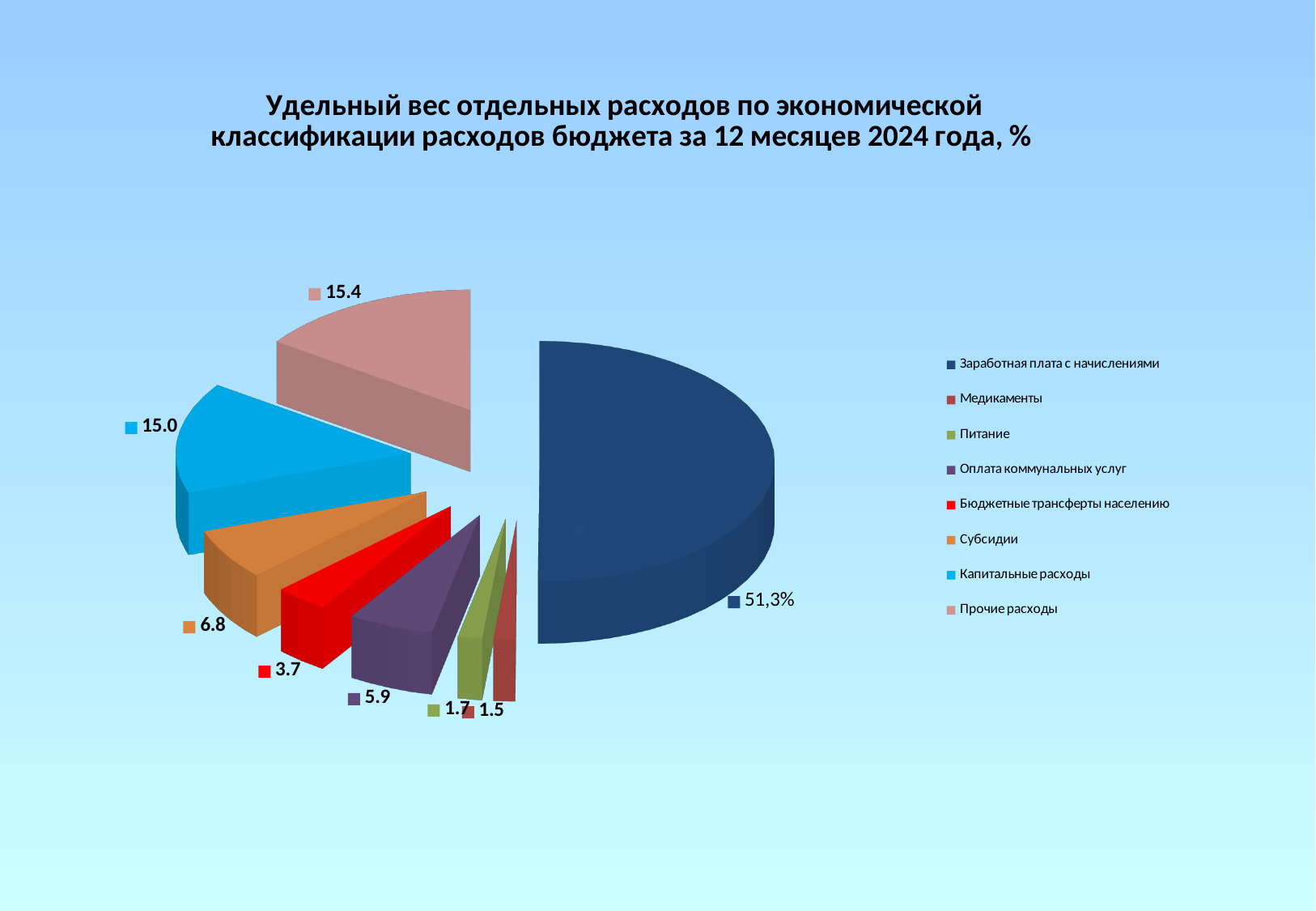
Which category has the smallest share of the pie? Медикаменты What is the difference between the values for Субсидии and Бюджетные трансферты населению? 3.1 What is the value for Медикаменты? 1.5 What colour is the slice for Капитальные расходы? light blue What is the value for Прочие расходы? 15.4 Which is larger, Оплата коммунальных услуг or Бюджетные трансферты населению? Оплата коммунальных услуг How many categories does the legend list? 8 What kind of chart is shown on the slide? pie chart What is the value for Заработная плата с начислениями? 51,3% Which category has the largest share of the pie? Заработная плата с начислениями What is the value for Капитальные расходы? 15.0 What is the value for Субсидии? 6.8